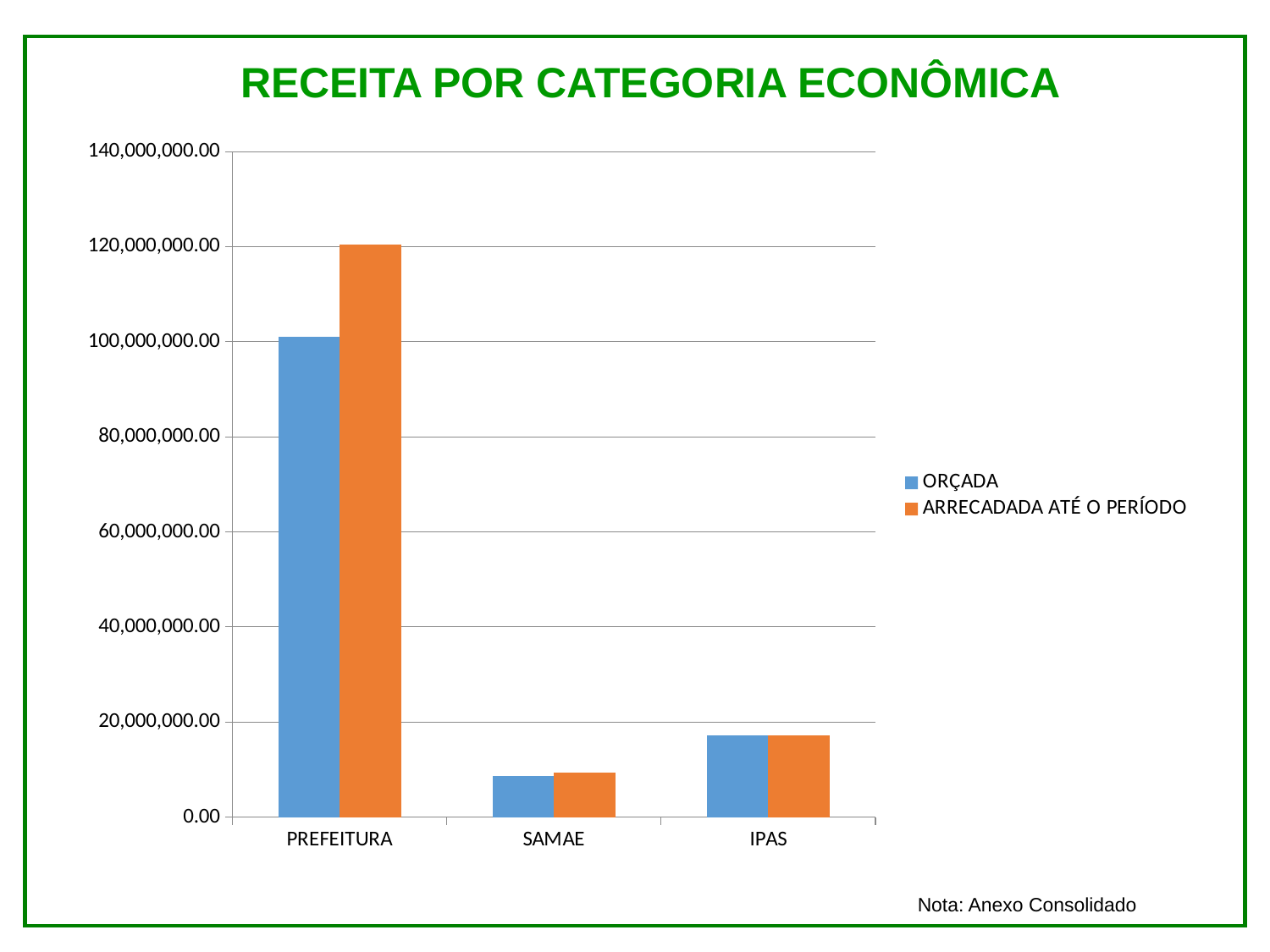
Which category has the lowest ARRECADADA ATÉ O PERÍODO value? SAMAE What is the title of the chart? RECEITA POR CATEGORIA ECONÔMICA Which category has the highest ORÇADA value? PREFEITURA How many categories are shown on the x axis? 3 For PREFEITURA, which is larger: ORÇADA or ARRECADADA ATÉ O PERÍODO? ARRECADADA ATÉ O PERÍODO Which colour represents the ARRECADADA ATÉ O PERÍODO series? orange How many series does the legend list? 2 Is the ARRECADADA ATÉ O PERÍODO value for PREFEITURA greater or less than 100,000,000.00? greater What kind of chart is shown on the slide? bar chart Is the ORÇADA value for SAMAE greater or less than 20,000,000.00? less Which category has the lowest ORÇADA value? SAMAE Is the ORÇADA value for PREFEITURA greater or less than 80,000,000.00? greater